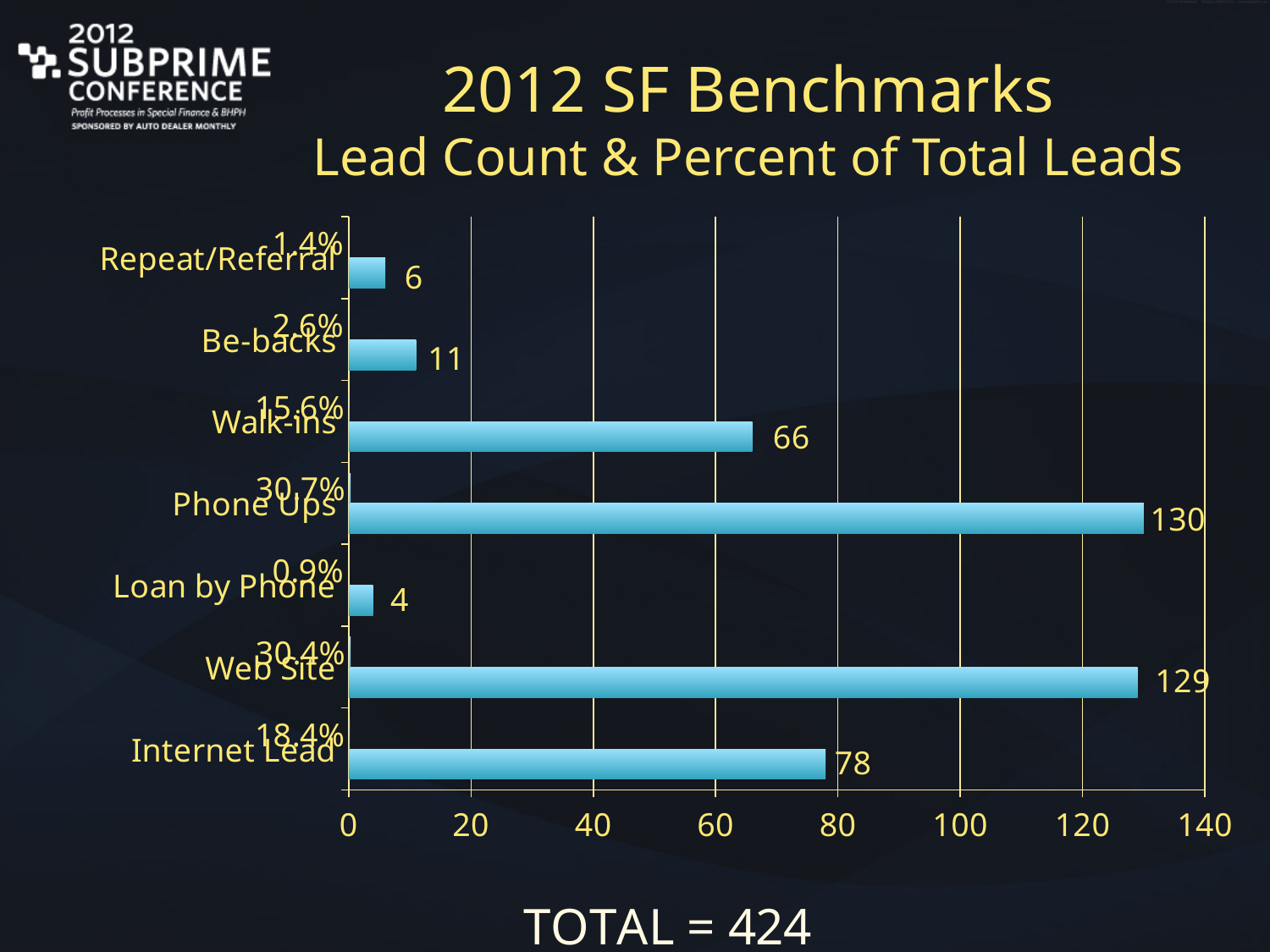
What total lead count is stated below the chart? 424 Which category has the lowest lead count? Loan by Phone Which has a higher lead count, Walk-ins or Internet Lead? Internet Lead What is the lead count for Internet Lead? 78 What is the lead count for Walk-ins? 66 What percent of total leads does Repeat/Referral represent? 1.4% What is the difference in lead count between Internet Lead and Walk-ins? 12 What is the lead count for Be-backs? 11 Is the value for Phone Ups greater or less than 120? greater What percent of total leads do Phone Ups represent? 30.7% How many lead source categories are plotted in the chart? 7 What kind of chart is shown on the slide? bar chart